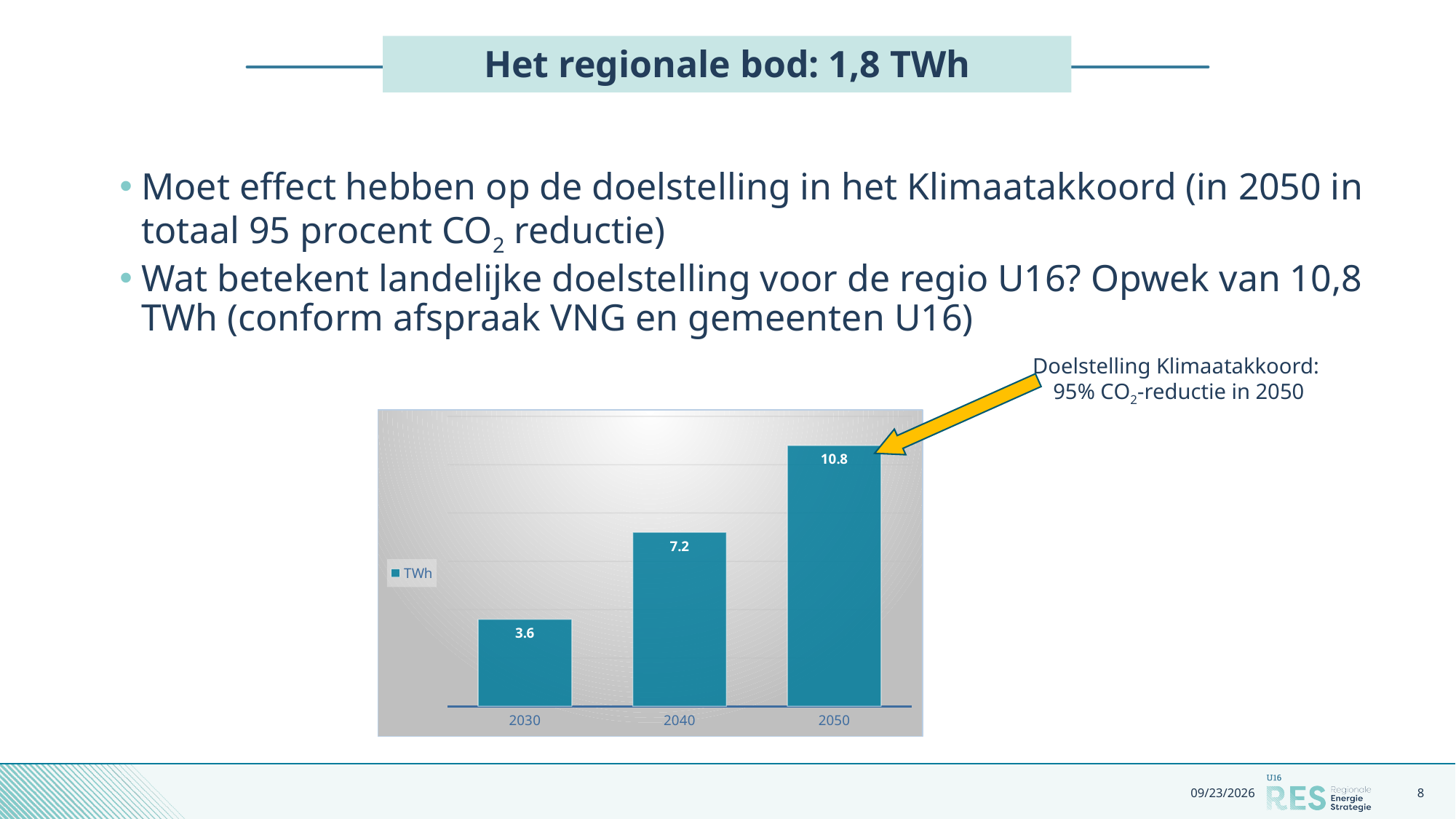
Which year has the highest value? 2050 What is the difference between the values for 2050 and 2030? 7.2 What is the value for 2040? 7.2 How many series does the legend list? 1 What is the value for 2050? 10.8 Do the values rise or fall from 2030 to 2050? rise What is the value for 2030? 3.6 How many years are shown on the x axis? 3 What is the difference between the values for 2040 and 2030? 3.6 What kind of chart is shown? bar chart Which year has the lowest value? 2030 Which is larger, the value for 2040 or the value for 2050? 2050